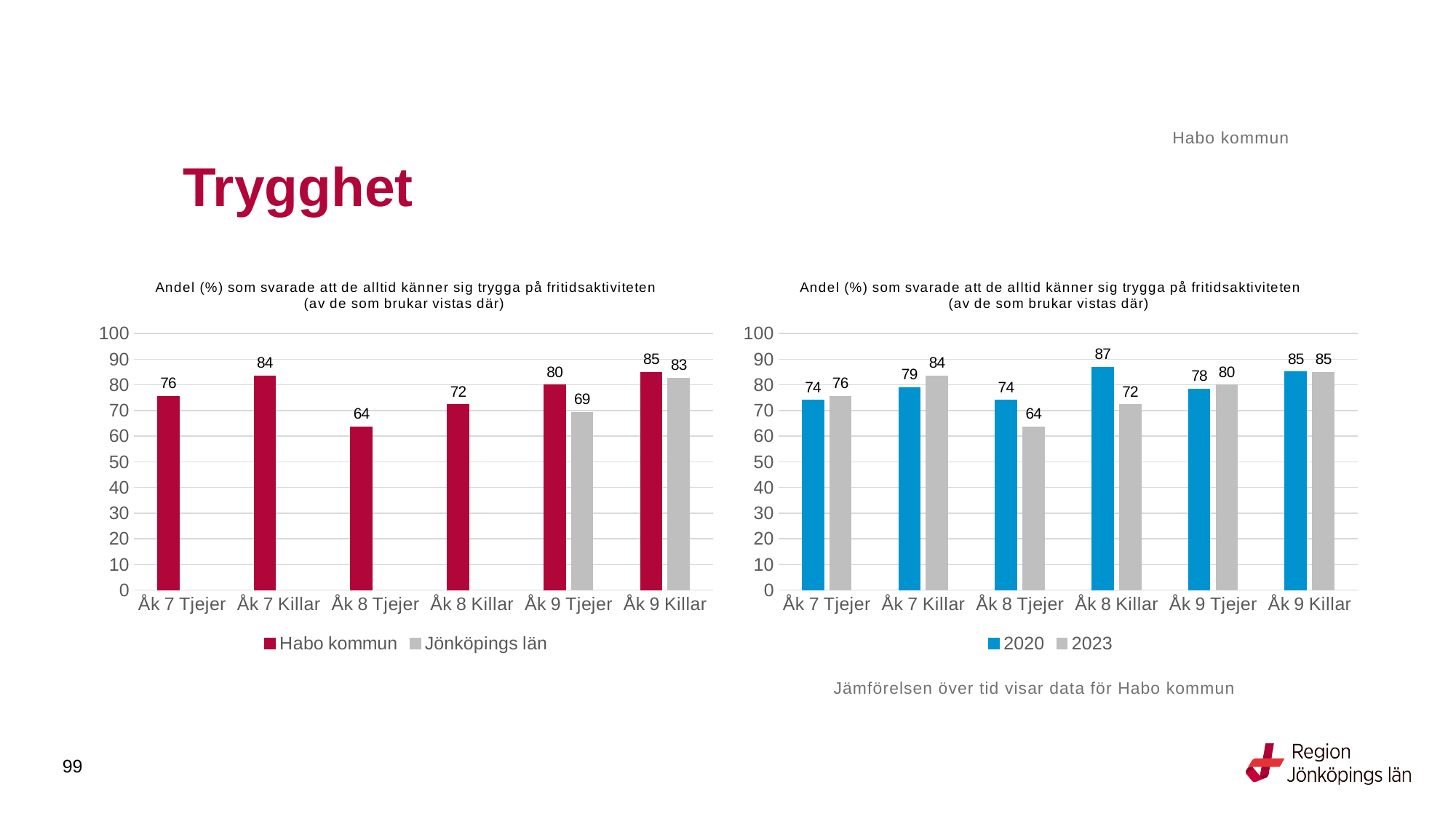
In the right chart, which category has the lowest value for 2023? Åk 8 Tjejer In the right chart, what is the value for 2023 for Åk 7 Killar? 84 In the left chart, what is the value for Habo kommun for Åk 8 Tjejer? 64 How many categories are shown on the x axis of the right chart? 6 In the left chart, what is the difference between Habo kommun and Jönköpings län for Åk 9 Killar? 2 In the left chart, how many series does the legend list? 2 In the right chart, what is the value for 2020 for Åk 8 Killar? 87 In the right chart, which is larger for Åk 8 Tjejer, the 2020 value or the 2023 value? 2020 In the right chart, what is the difference between the 2020 and 2023 values for Åk 8 Killar? 15 What kind of chart is the left chart? Bar chart In the left chart, what is the value for Jönköpings län for Åk 9 Tjejer? 69 In the left chart, which category has the highest value for Habo kommun? Åk 9 Killar